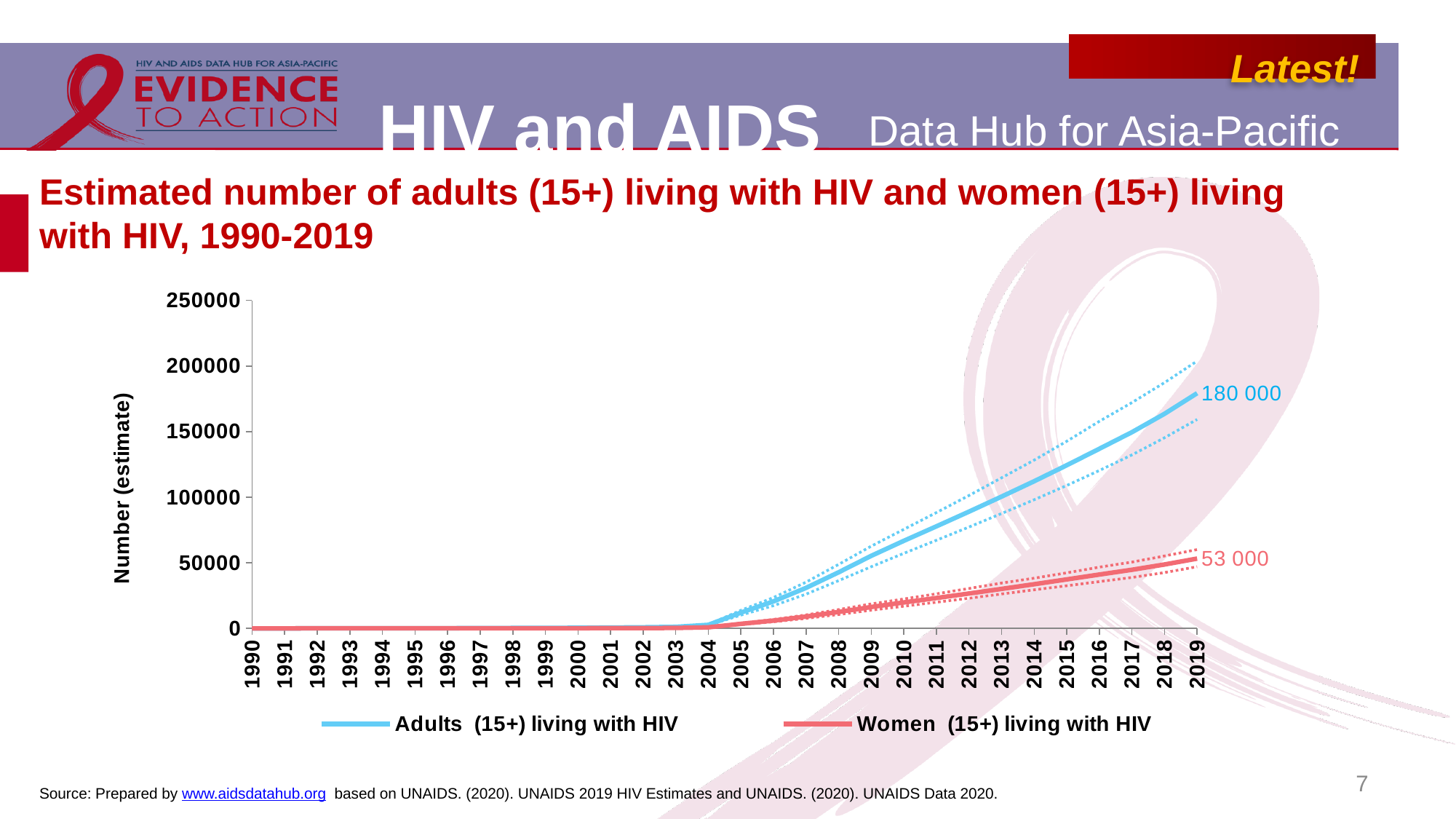
What is the estimated number of women (15+) living with HIV in 2019? 53 000 How many years are shown on the x axis of the chart? 30 In 2019, which series has the larger value: Adults (15+) living with HIV or Women (15+) living with HIV? Adults (15+) living with HIV Is the value for Women (15+) living with HIV in 2015 greater or less than 50000? less What is the estimated number of adults (15+) living with HIV in 2019? 180 000 What is the title of the y axis? Number (estimate) What kind of chart is shown on the slide? Line chart How many series does the legend list? 2 What is the difference between the 2019 values for adults (15+) living with HIV and women (15+) living with HIV? 127 000 Does the number of adults (15+) living with HIV rise or fall from 2004 to 2019? Rise Is the value for Adults (15+) living with HIV in 2005 greater or less than 50000? less Is the value for Adults (15+) living with HIV in 2015 greater or less than 100000? greater